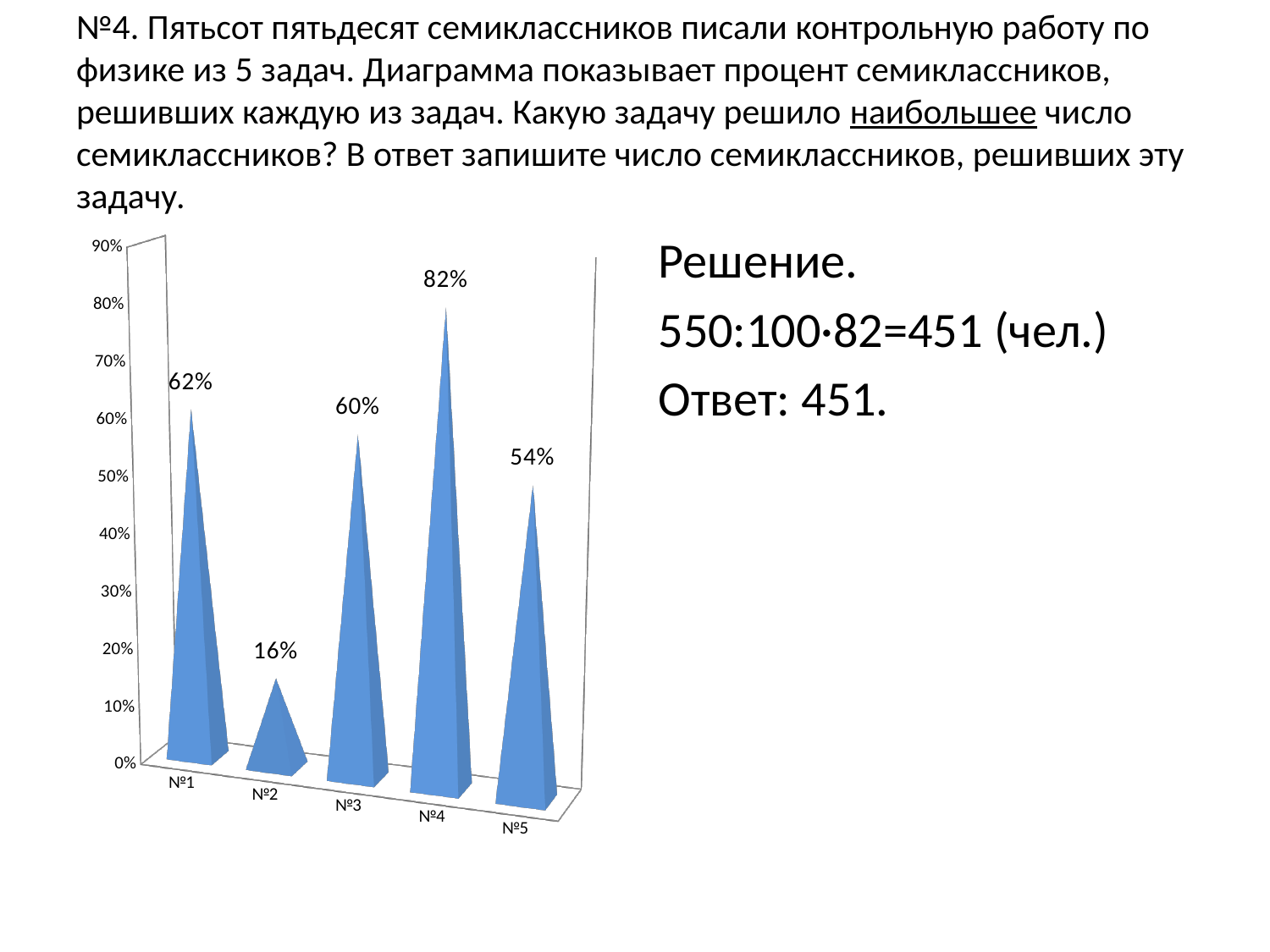
What kind of chart is shown on the slide? Bar chart What is the highest value shown on the vertical axis of the chart? 90% What percentage of seventh-graders solved problem №1? 62% Which problem was solved by the highest percentage of seventh-graders? №4 Which problem was solved by the lowest percentage of seventh-graders? №2 Which problem has a higher percentage of solvers, №3 or №5? №3 What percentage of seventh-graders solved problem №4? 82% What percentage of seventh-graders solved problem №2? 16% What is the difference in percentage points between problem №4 and problem №2? 66 What is the difference in percentage points between problem №1 and problem №3? 2 What percentage of seventh-graders solved problem №5? 54% How many problems (categories) are shown on the chart? 5